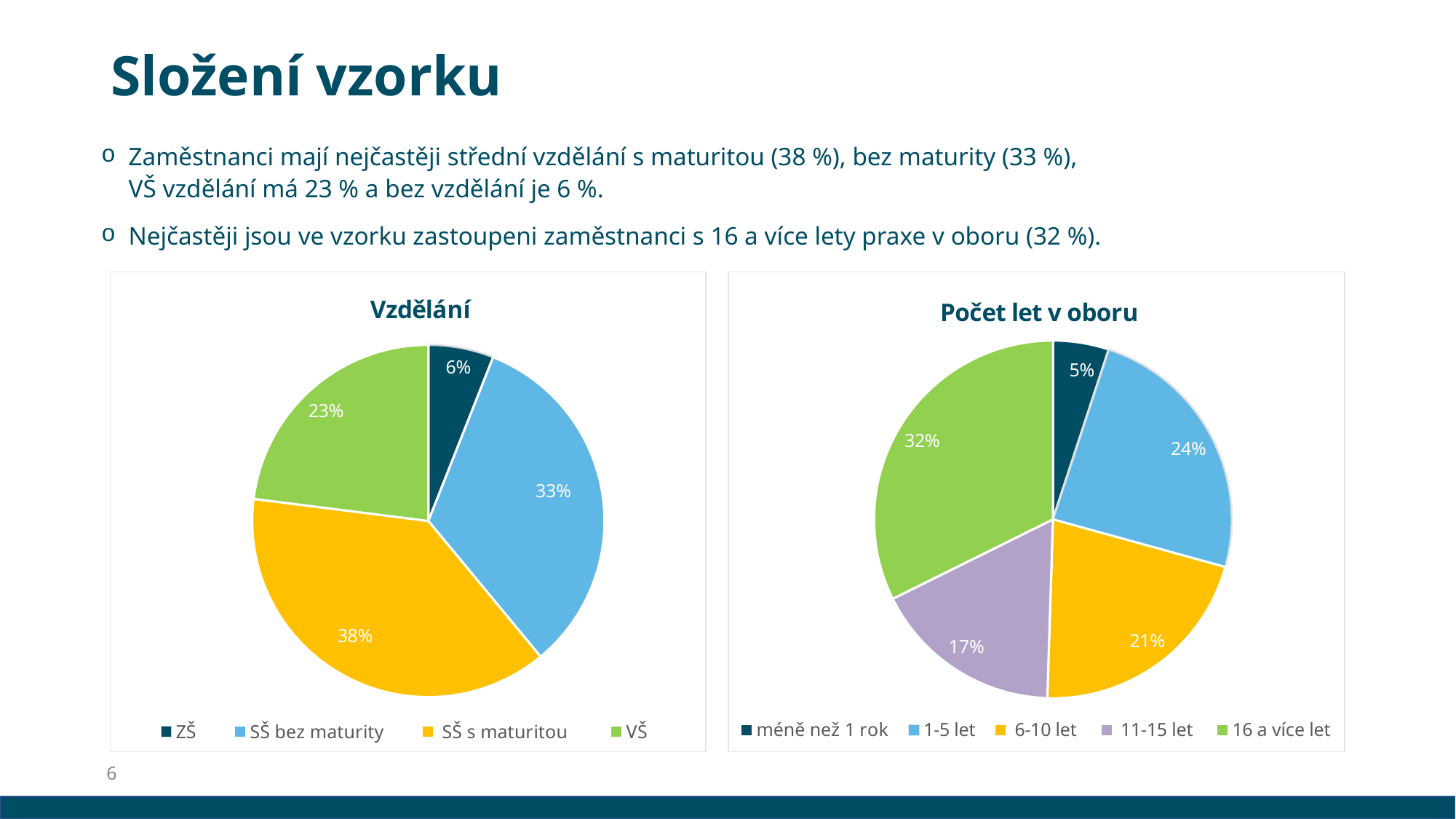
In the "Vzdělání" chart, what is the difference between the shares of "SŠ bez maturity" and "VŠ"? 10% In the "Počet let v oboru" chart, which category has the largest share? 16 a více let In the "Vzdělání" chart, which category has the largest share? SŠ s maturitou In the "Vzdělání" chart, what share does "VŠ" have? 23% In the "Počet let v oboru" chart, how many categories does the legend list? 5 In the "Počet let v oboru" chart, what share does "1-5 let" have? 24% In the "Vzdělání" chart, how many categories does the legend list? 4 What type of chart is the "Počet let v oboru" chart? Pie chart In the "Počet let v oboru" chart, which is larger, "6-10 let" or "11-15 let"? 6-10 let In the "Vzdělání" chart, what share does "SŠ s maturitou" have? 38% In the "Vzdělání" chart, which category has the smallest share? ZŠ In the "Počet let v oboru" chart, what share does "11-15 let" have? 17%